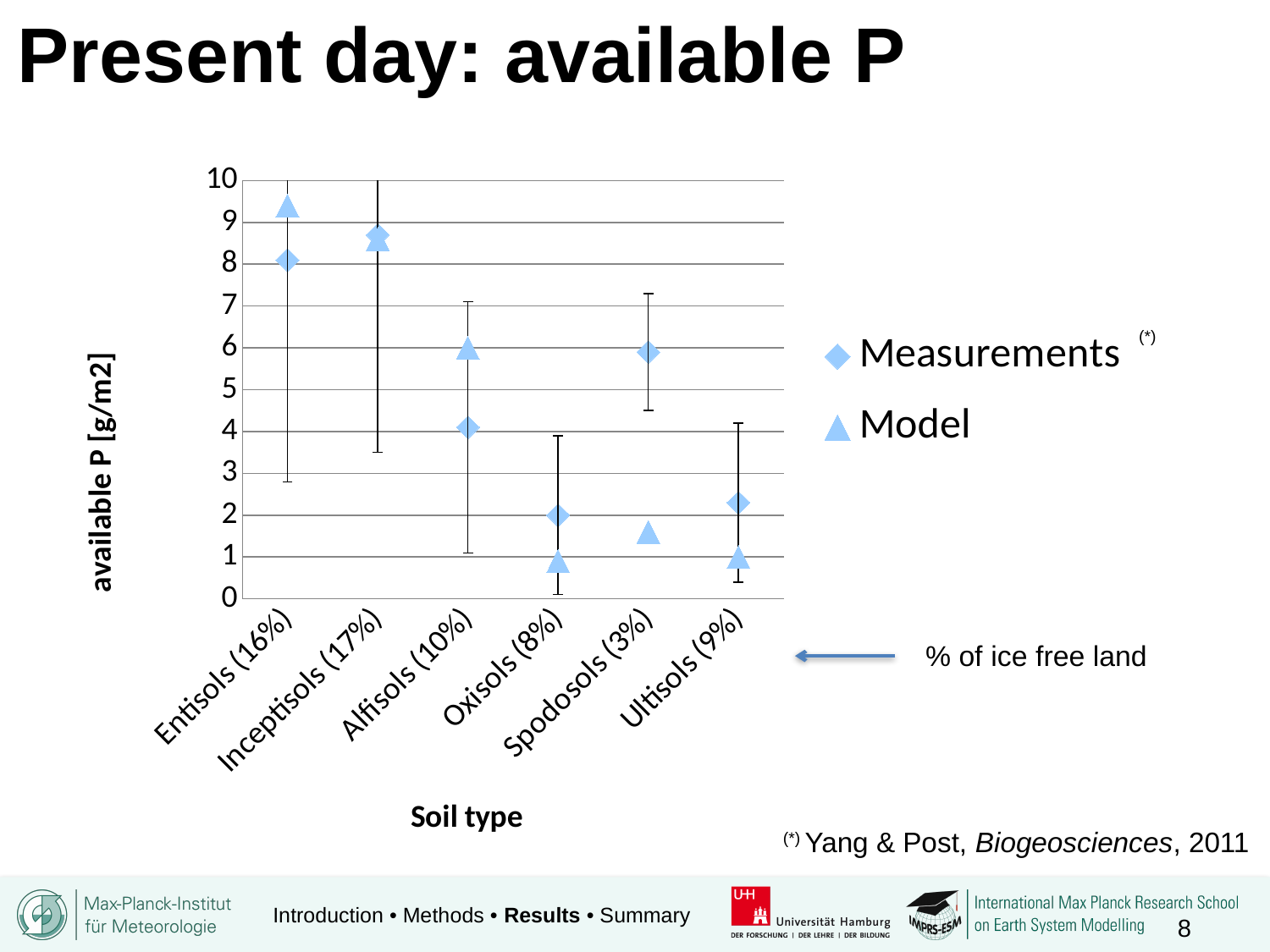
Which soil type has the highest Model value? Entisols (16%) For Spodosols (3%), which is larger: the Measurements value or the Model value? Measurements Is the Measurements value for Alfisols (10%) greater or less than 5? less How many series does the legend list? 2 For Alfisols (10%), which is larger: the Model value or the Measurements value? Model What kind of chart is shown on the slide? scatter chart Is the Measurements value for Spodosols (3%) greater or less than 5? greater What is the title of the x axis? Soil type How many soil types are plotted along the x axis? 6 Is the Model value for Entisols (16%) greater or less than 9? greater What is the title of the y axis? available P [g/m2]